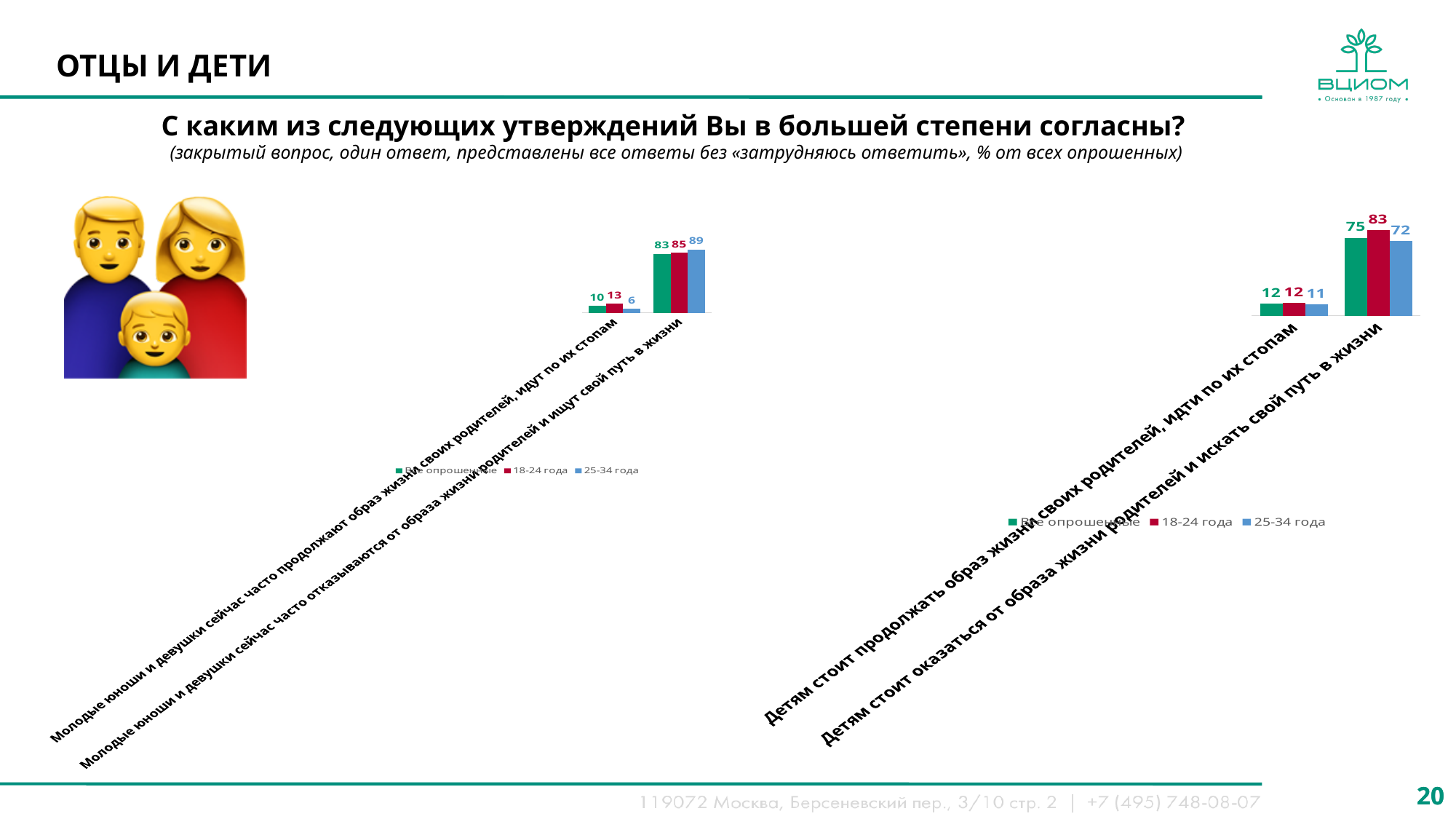
How many series does the legend of the right chart list? 3 On the left chart, what is the value for '18-24 года' for the statement 'Молодые юноши и девушки сейчас часто продолжают образ жизни своих родителей, идут по их стопам'? 13 What kind of chart is the left chart? Bar chart On the left chart, which series has the highest value for the statement 'Молодые юноши и девушки сейчас часто отказываются от образа жизни родителей и ищут свой путь в жизни'? 25-34 года How many categories are shown on the left chart? 2 On the left chart, what is the difference between the '18-24 года' and '25-34 года' values for the statement 'Молодые юноши и девушки сейчас часто продолжают образ жизни своих родителей, идут по их стопам'? 7 On the right chart, which is larger for '18-24 года': the value for 'Детям стоит продолжать образ жизни своих родителей, идти по их стопам' or for 'Детям стоит оказаться от образа жизни родителей и искать свой путь в жизни'? Детям стоит оказаться от образа жизни родителей и искать свой путь в жизни On the left chart, which series has the lowest value for the statement 'Молодые юноши и девушки сейчас часто продолжают образ жизни своих родителей, идут по их стопам'? 25-34 года On the right chart, what is the value for '25-34 года' for the statement 'Детям стоит продолжать образ жизни своих родителей, идти по их стопам'? 11 On the right chart, what is the value for 'Все опрошенные' for the statement 'Детям стоит оказаться от образа жизни родителей и искать свой путь в жизни'? 75 On the left chart, what is the value for '25-34 года' for the statement 'Молодые юноши и девушки сейчас часто отказываются от образа жизни родителей и ищут свой путь в жизни'? 89 On the right chart, what is the difference between the '18-24 года' and '25-34 года' values for the statement 'Детям стоит оказаться от образа жизни родителей и искать свой путь в жизни'? 11